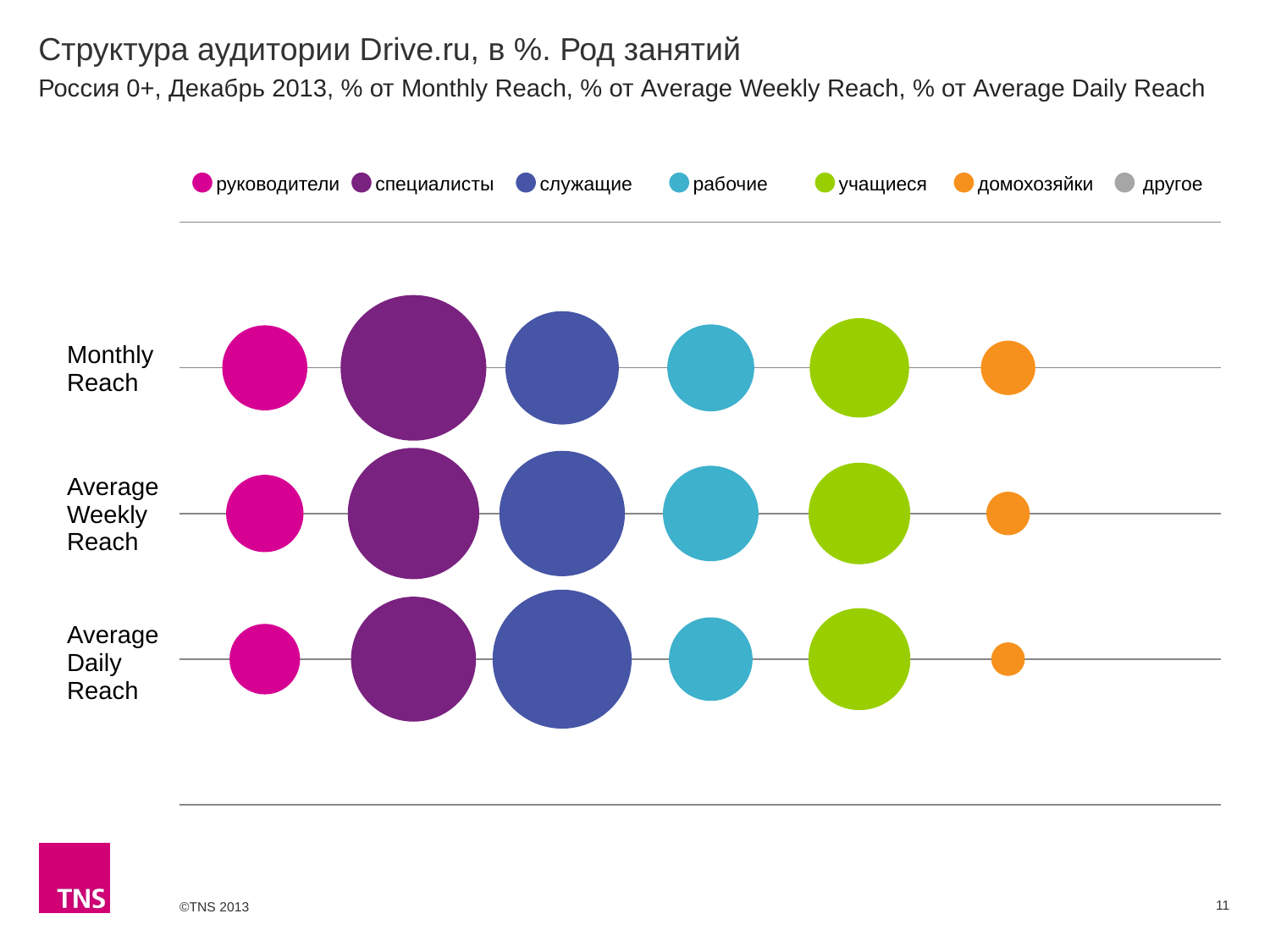
In the Monthly Reach row, which occupation group has the largest bubble? специалисты In the Average Daily Reach row, which occupation group has the smallest visible bubble? домохозяйки Which legend entry is shown in orange? домохозяйки In the Average Daily Reach row, which bubble is larger: служащие or рабочие? служащие In the Monthly Reach row, which occupation group has the smallest visible bubble? домохозяйки What kind of chart is shown on the slide? bubble chart How many series does the legend list? 7 How many reach categories (rows) are plotted on the chart? 3 In the Average Weekly Reach row, which occupation group has the smallest visible bubble? домохозяйки Does the bubble for служащие grow or shrink going from Monthly Reach to Average Daily Reach? grow In the Monthly Reach row, which bubble is larger: специалисты or руководители? специалисты In the Monthly Reach row, which bubble is larger: учащиеся or рабочие? учащиеся